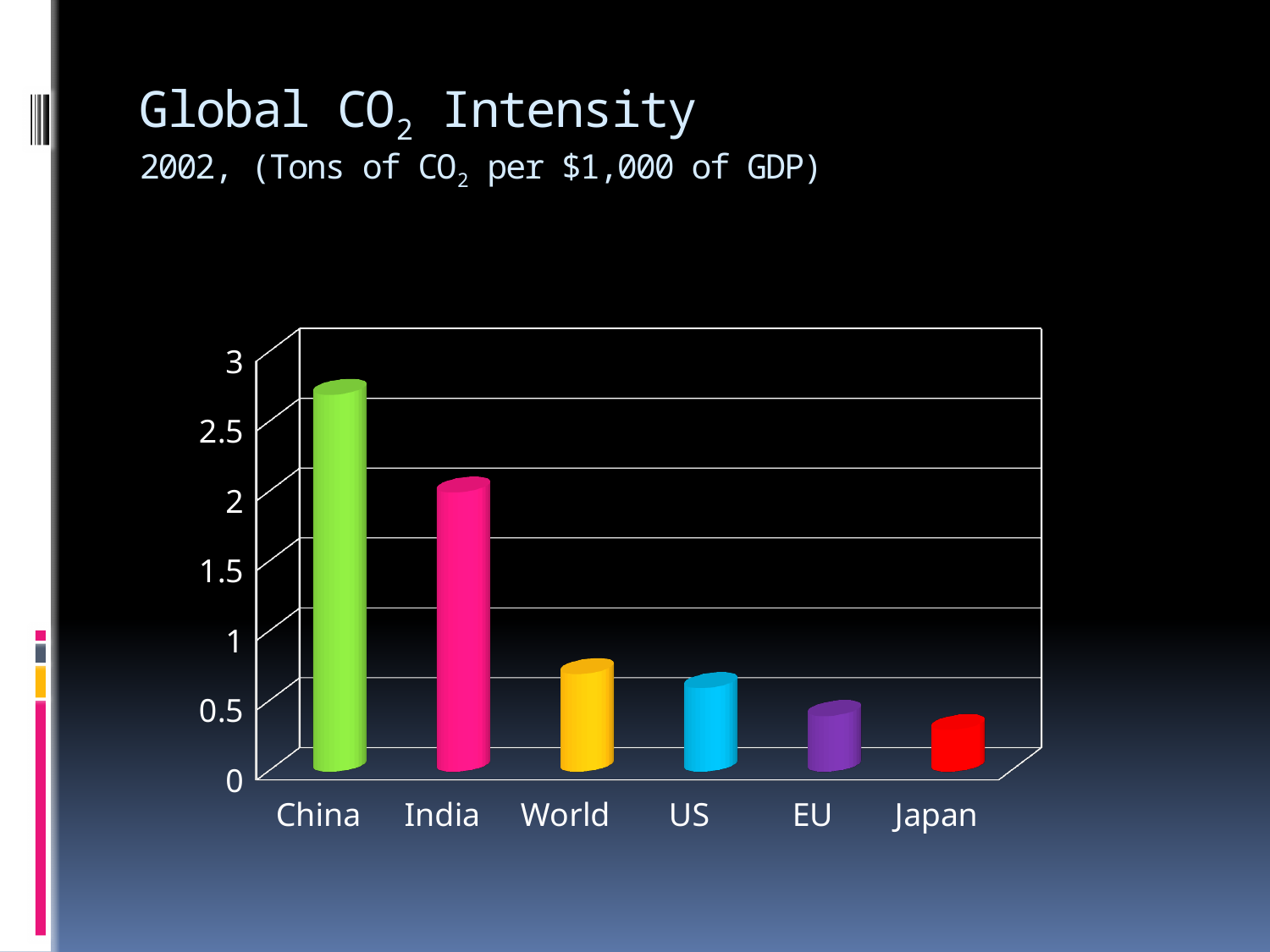
How many categories are shown on the x axis of the chart? 6 Is the value for China greater or less than 2.5? greater Which category has the lowest CO2 intensity in the chart? Japan Which category has the highest CO2 intensity in the chart? China Is the value for World greater or less than 1? less Is the value for Japan greater or less than 0.5? less Which has a higher CO2 intensity, China or India? China Do the values rise or fall moving from left to right along the x axis? fall What kind of chart is shown on the slide? bar chart What colour is the bar for China? green